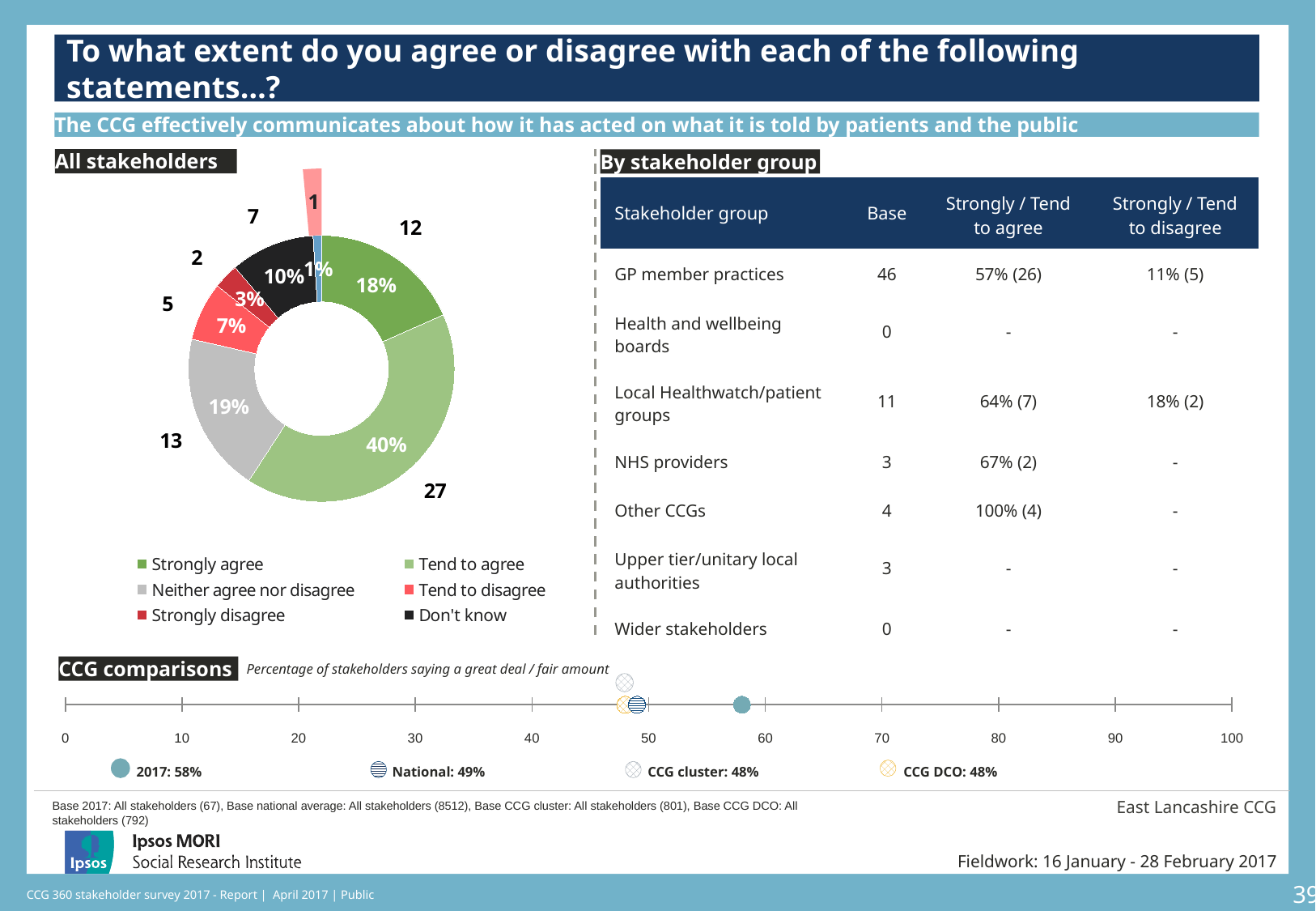
In the All stakeholders donut chart, what percentage of stakeholders said they neither agree nor disagree? 19% In the CCG comparisons chart, what is the 2017 value for this CCG? 58% In the All stakeholders donut chart, what percentage of stakeholders answered 'Don't know'? 10% In the All stakeholders donut chart, what is the difference in percentage points between 'Tend to agree' and 'Strongly agree'? 22 How many entries does the legend of the All stakeholders chart list? 6 In the All stakeholders donut chart, what percentage of stakeholders said they strongly agree? 18% In the All stakeholders donut chart, what percentage of stakeholders said they tend to agree? 40% In the CCG comparisons chart, what is the difference between the 2017 value and the National value? 9 percentage points In the All stakeholders donut chart, which is larger: the share for 'Tend to disagree' or the share for 'Strongly disagree'? Tend to disagree What type of chart is used for the All stakeholders section? Donut chart In the All stakeholders donut chart, which response category has the largest share? Tend to agree In the All stakeholders donut chart, how many stakeholders said they tend to disagree? 5